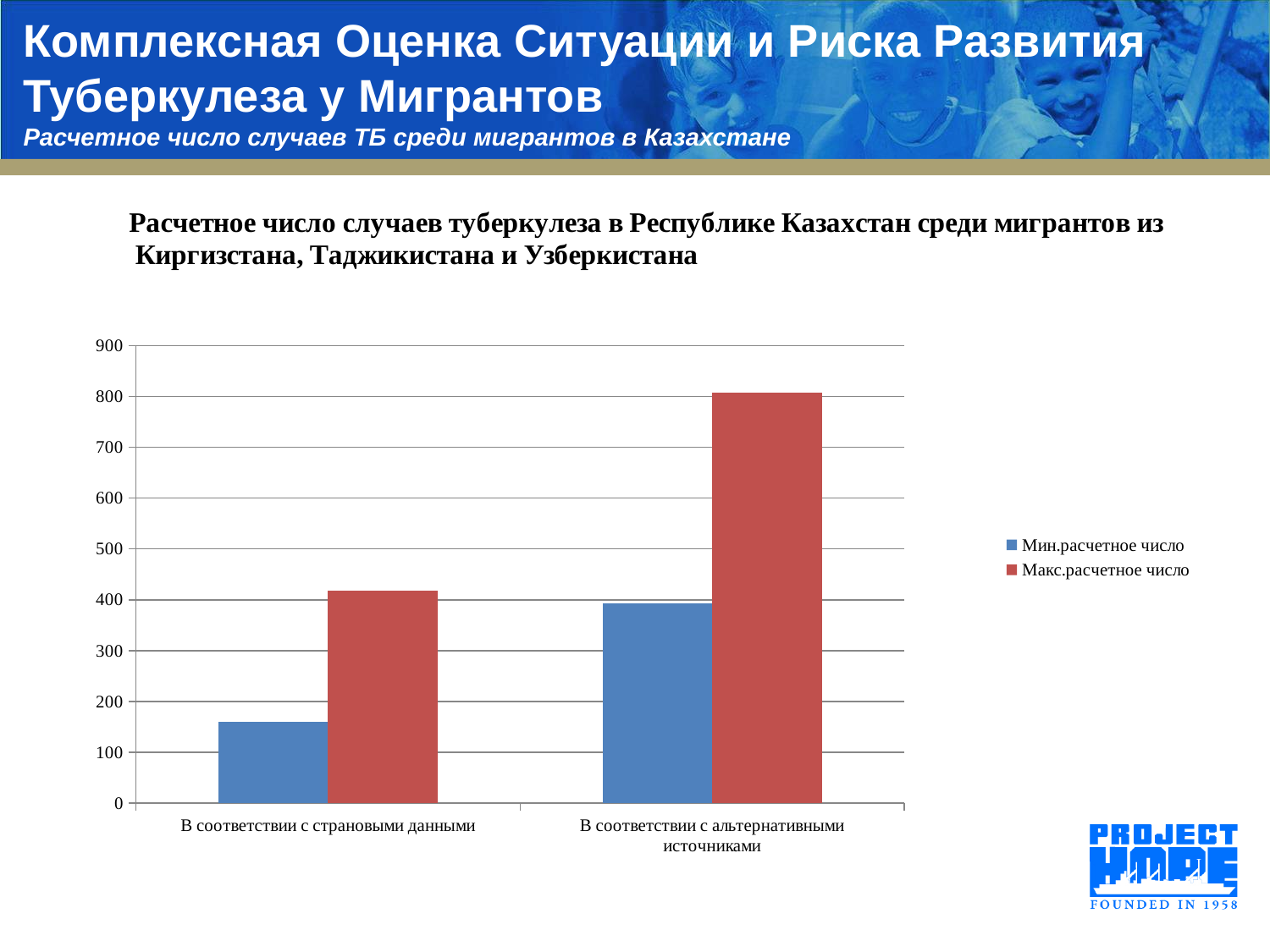
How many series does the legend list? 2 What kind of chart is shown on the slide? bar chart How many categories are shown on the x axis? 2 Is the value of Макс.расчетное число for 'В соответствии с альтернативными источниками' greater or less than 700? greater Is the value of Мин.расчетное число for 'В соответствии с страновыми данными' greater or less than 200? less Which category has the lowest Мин.расчетное число value? В соответствии с страновыми данными Which is larger: Мин.расчетное число for 'В соответствии с альтернативными источниками' or Макс.расчетное число for 'В соответствии с страновыми данными'? Макс.расчетное число for 'В соответствии с страновыми данными' Which series is shown in blue? Мин.расчетное число Which category has the highest Макс.расчетное число value? В соответствии с альтернативными источниками Is the value of Макс.расчетное число for 'В соответствии с страновыми данными' greater or less than 400? greater Which series is shown in red? Макс.расчетное число